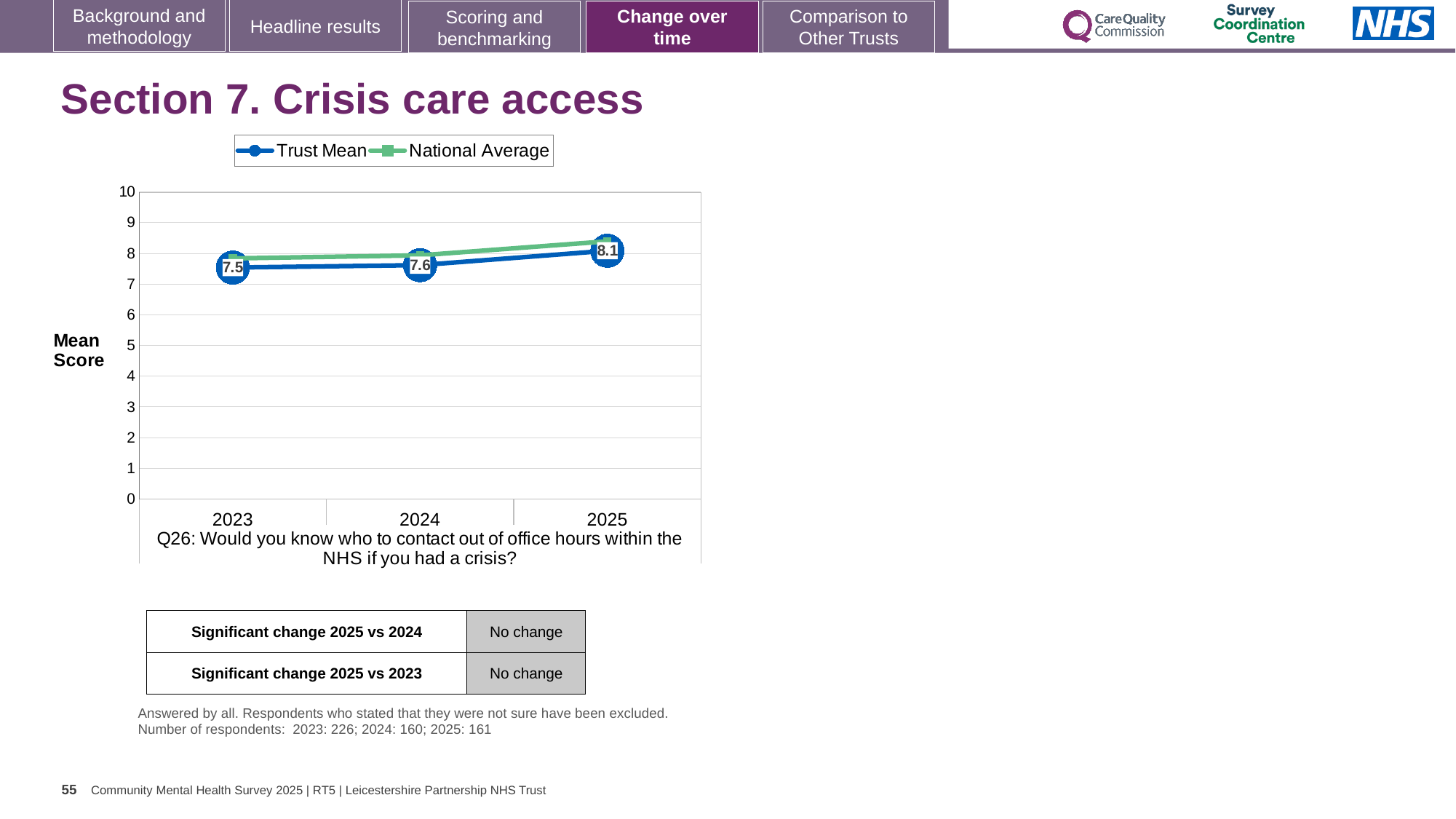
Is the National Average for 2025 greater or less than 8? greater Does the Trust Mean rise or fall from 2023 to 2025? rise What kind of chart is shown? line chart Which is larger, the Trust Mean in 2025 or in 2024? 2025 How many years are plotted on the x axis? 3 In which year is the Trust Mean lowest? 2023 What is the Trust Mean score for 2024? 7.6 How many series does the legend list? 2 What is the Trust Mean score for 2025? 8.1 In which year is the Trust Mean highest? 2025 What is the difference between the Trust Mean in 2025 and in 2023? 0.6 What is the Trust Mean score for 2023? 7.5